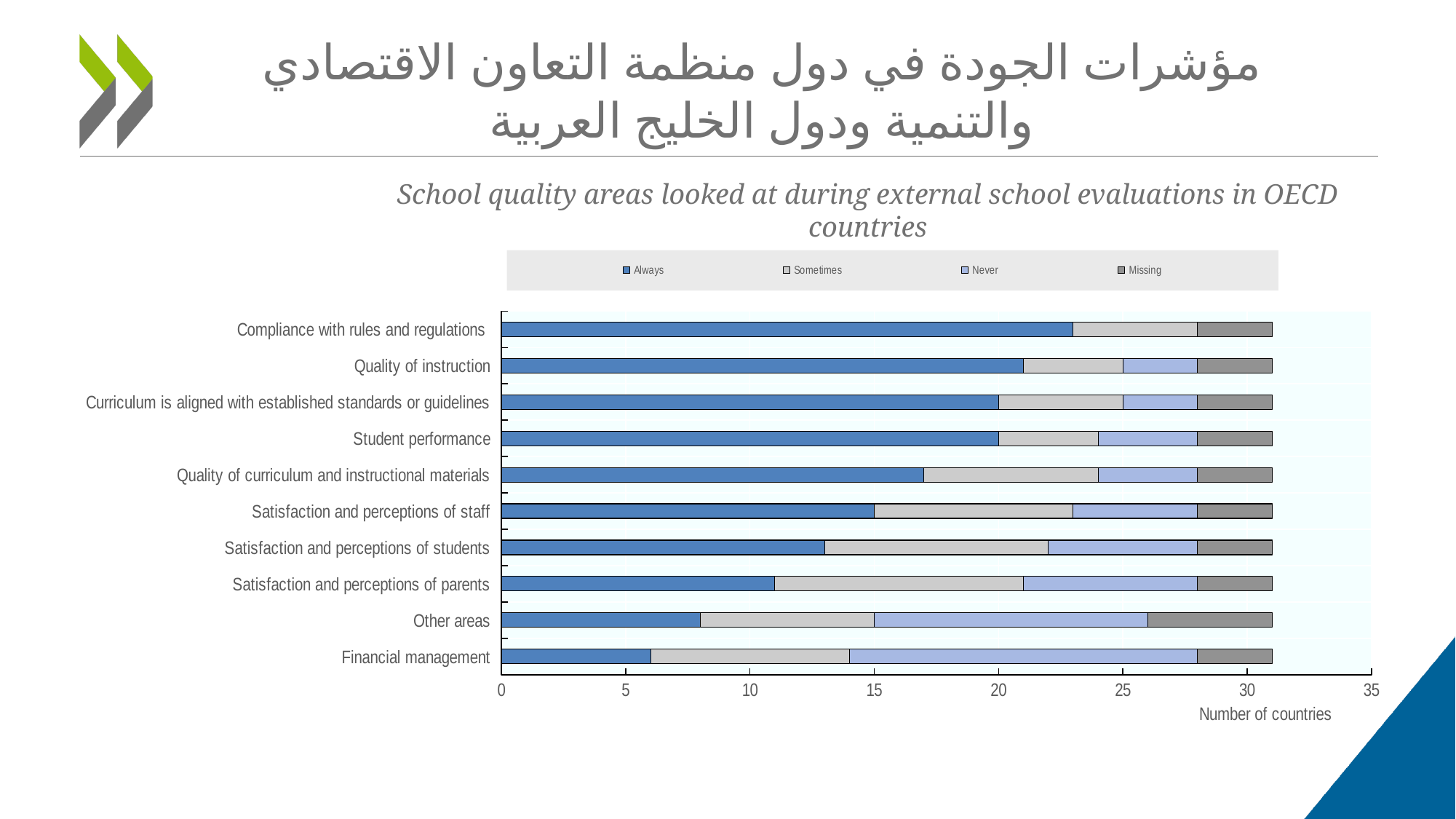
What is the label of the horizontal axis? Number of countries Is the 'Always' value for Compliance with rules and regulations greater or less than 20? greater What kind of chart is shown on the slide? Stacked bar chart Which school quality area has the largest 'Always' segment? Compliance with rules and regulations Is the 'Always' value for Satisfaction and perceptions of students greater or less than 10? greater What is the title of the chart? School quality areas looked at during external school evaluations in OECD countries Is the 'Always' value for Quality of curriculum and instructional materials greater or less than 20? less Which has a larger 'Always' segment: Other areas or Satisfaction and perceptions of parents? Satisfaction and perceptions of parents How many series does the legend list? 4 Which school quality area has the smallest 'Always' segment? Financial management How many school quality areas (categories) are listed on the chart? 10